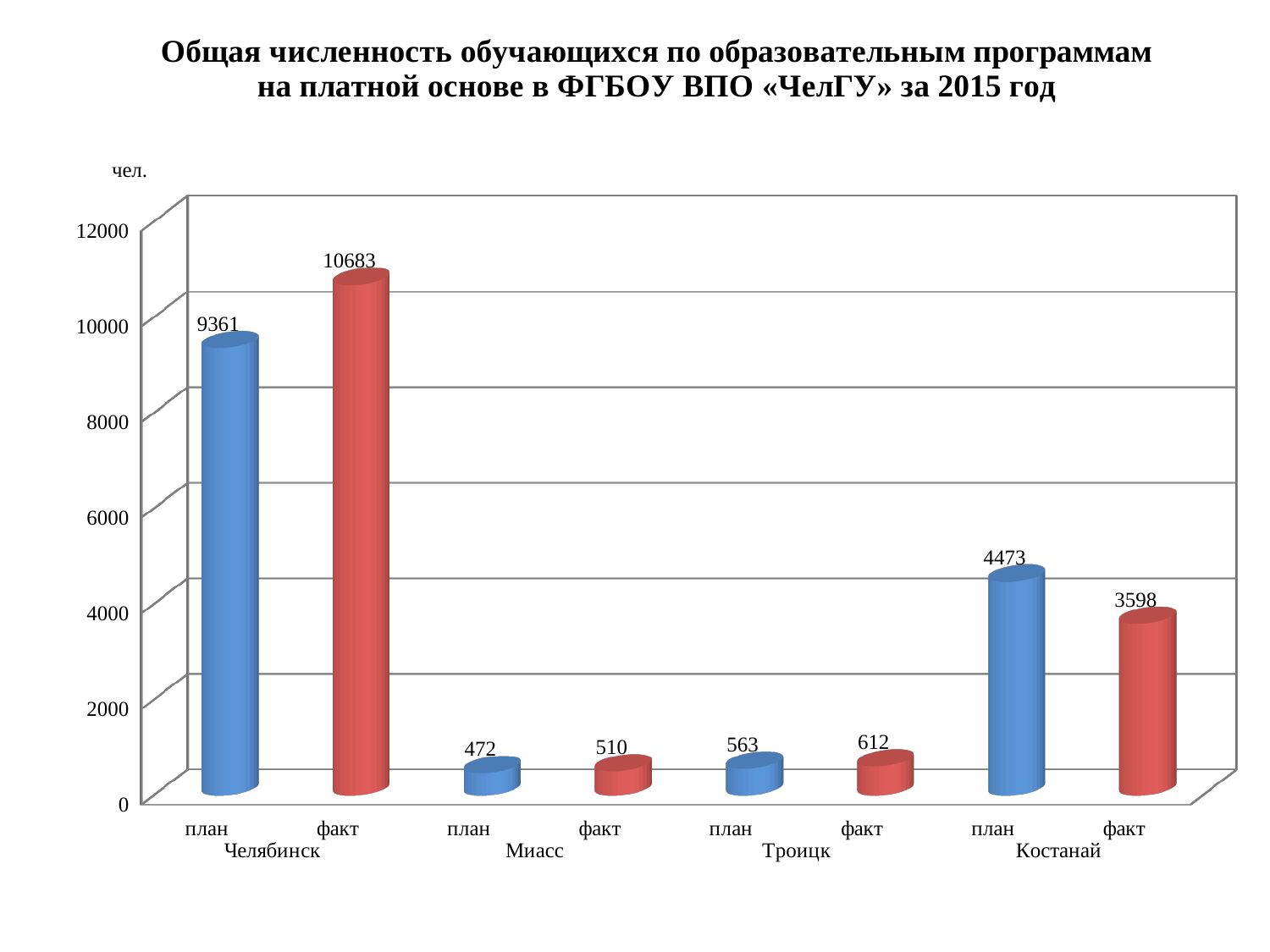
What is the value of the план bar for Миасс? 472 What unit is shown on the vertical axis of the chart? чел. How many bars are plotted on the chart? 8 Which bar has the lowest value on the chart? план for Миасс What is the difference between the факт and план values for Челябинск? 1322 What is the value of the факт bar for Троицк? 612 What kind of chart is shown on the slide? bar chart Which is larger for Троицк, план or факт? факт What is the value of the план bar for Костанай? 4473 Which bar has the highest value on the chart? факт for Челябинск What is the value of the факт bar for Челябинск? 10683 What is the difference between the план and факт values for Костанай? 875